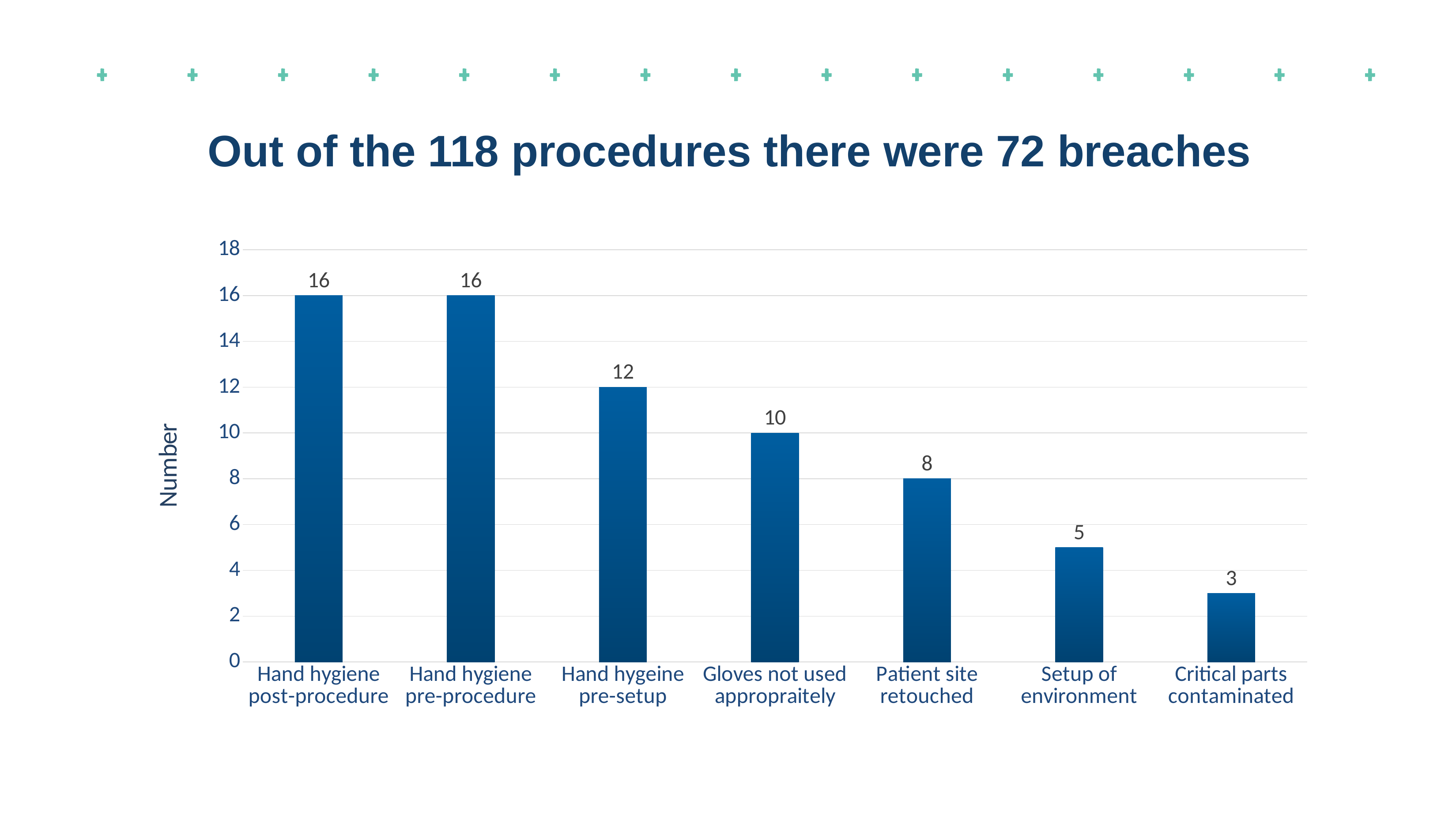
What is the value for Gloves not used appropraitely? 10 Which is larger, the value for Gloves not used appropraitely or the value for Setup of environment? Gloves not used appropraitely What kind of chart is shown on the slide? Bar chart What is the label of the vertical axis? Number How many categories are shown on the x axis? 7 Do the values rise or fall from left to right along the x axis? Fall What is the value for Patient site retouched? 8 What is the difference between the values for Hand hygiene post-procedure and Critical parts contaminated? 13 What is the difference between the values for Hand hygeine pre-setup and Patient site retouched? 4 What is the value for Setup of environment? 5 Which category has the lowest value? Critical parts contaminated What is the value for Hand hygeine pre-setup? 12